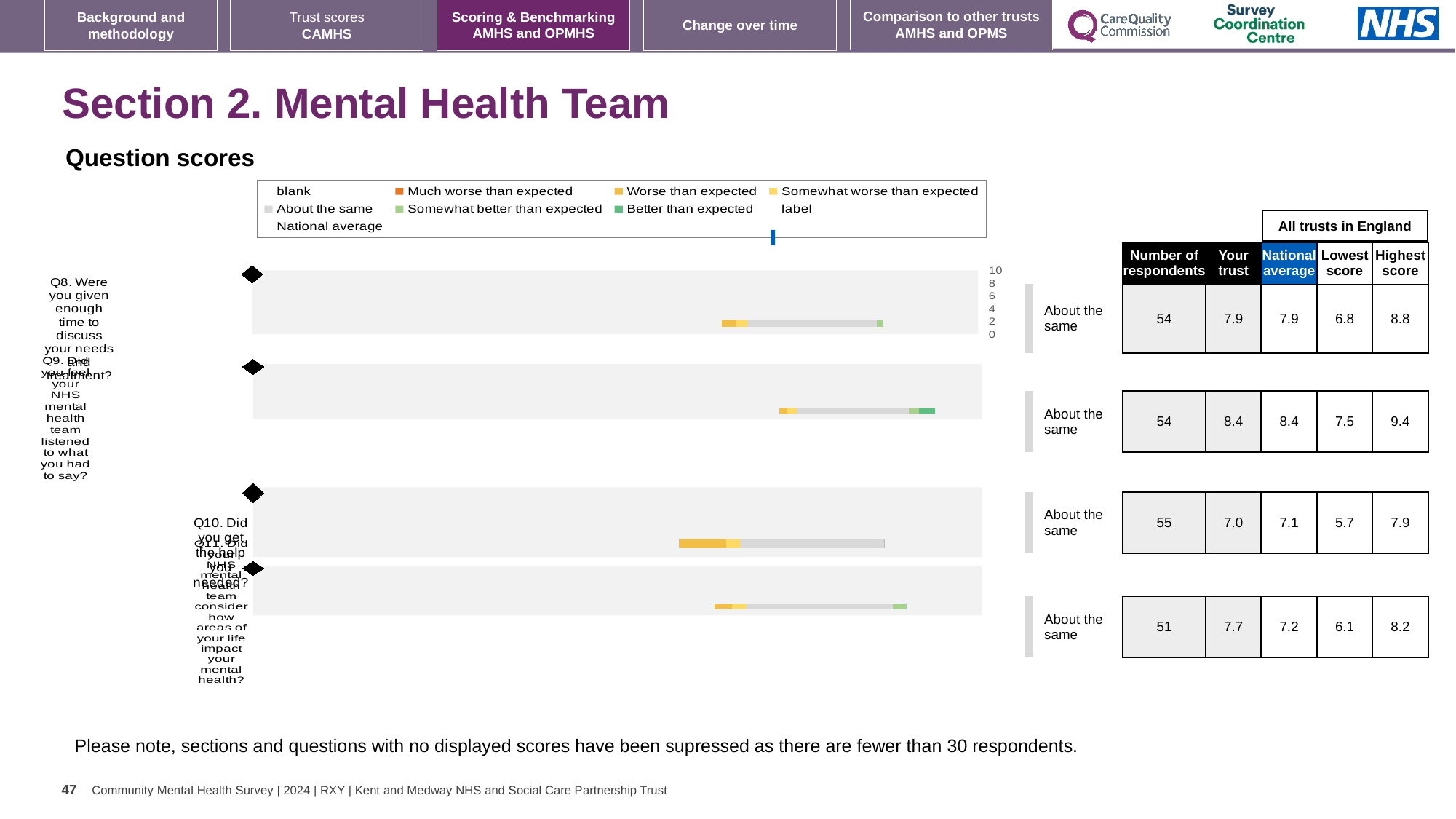
For Q10, which is larger: the 'Your trust' score or the national average? National average In the table beside the chart, what is the number of respondents for Q10 (Did you get the help you needed)? 55 Which question has the highest 'Your trust' score in the table beside the chart? Q9 What kind of chart is used to show the question scores on this slide? bar chart In the table beside the chart, what is the highest score across all trusts in England for Q9? 9.4 How many questions (Q8 to Q11) are plotted in the question scores chart? 4 What colour does the chart legend use for 'Better than expected'? Green For Q11, what is the difference between the 'Your trust' score (7.7) and the national average (7.2)? 0.5 What benchmark label is shown next to the chart row for Q8? About the same In the table beside the chart, what is the 'Your trust' score for Q8 (Were you given enough time to discuss your needs and treatment)? 7.9 Which question has the lowest number of respondents in the table beside the chart? Q11 In the table beside the chart, what is the lowest score across all trusts in England for Q10? 5.7